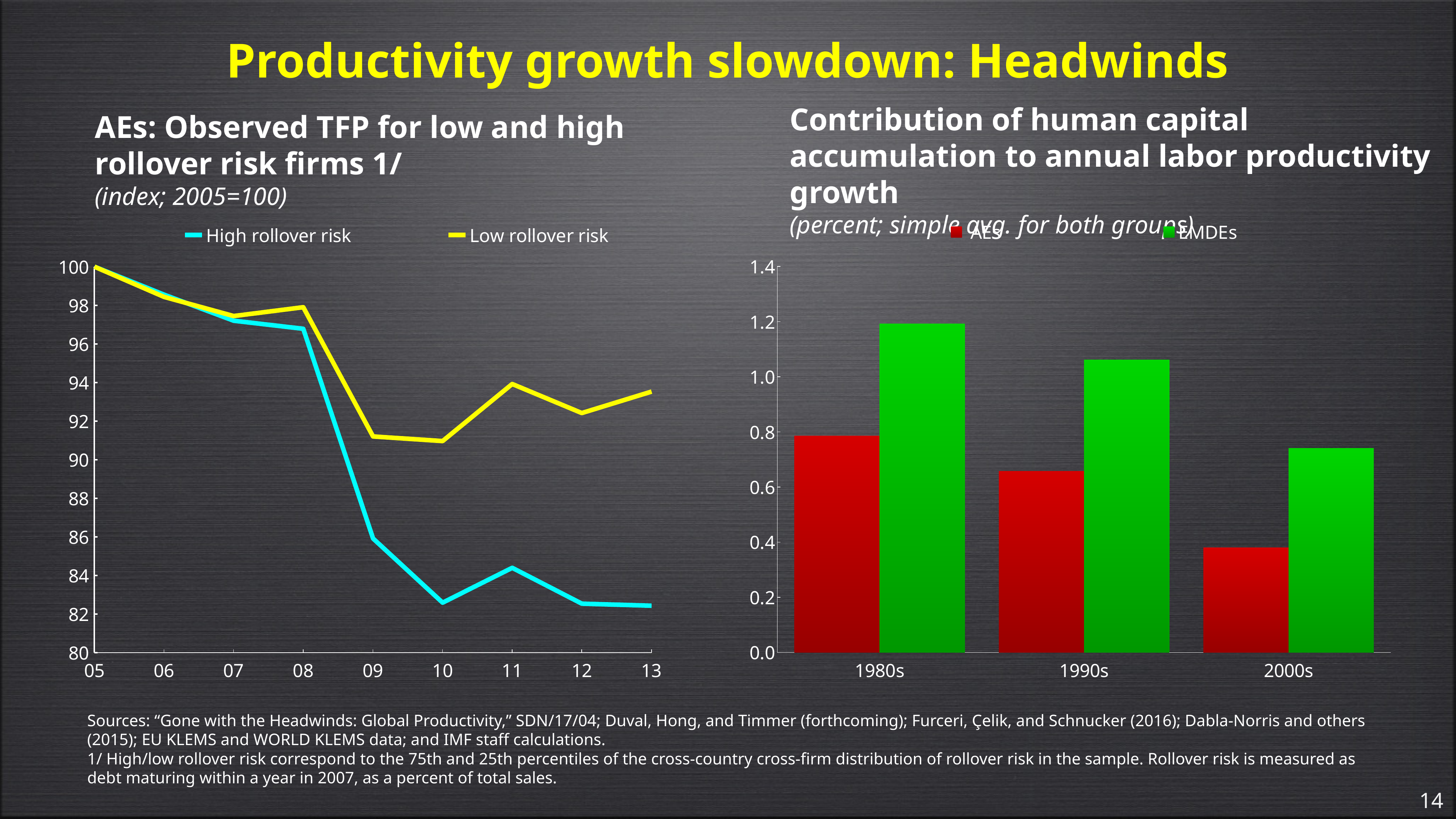
In the left chart, what is the value of both series in 05? 100 In the left chart, does the High rollover risk series generally rise or fall from 05 to 13? fall In the right chart, which decade has the highest EMDEs bar? 1980s In the right chart, how many decade categories are shown on the x axis? 3 In the right chart, is the value for AEs in the 2000s greater or less than 0.4? less In the left chart, is the value for High rollover risk in 10 greater or less than 84? less What kind of chart is the left chart, 'AEs: Observed TFP for low and high rollover risk firms'? line chart What kind of chart is the right chart, 'Contribution of human capital accumulation to annual labor productivity growth'? bar chart In the left chart, is the value for Low rollover risk in 11 greater or less than 92? greater In the left chart, which series has the lower value in 13? High rollover risk In the right chart, which decade has the lowest AEs bar? 2000s In the left chart, how many series does the legend list? 2